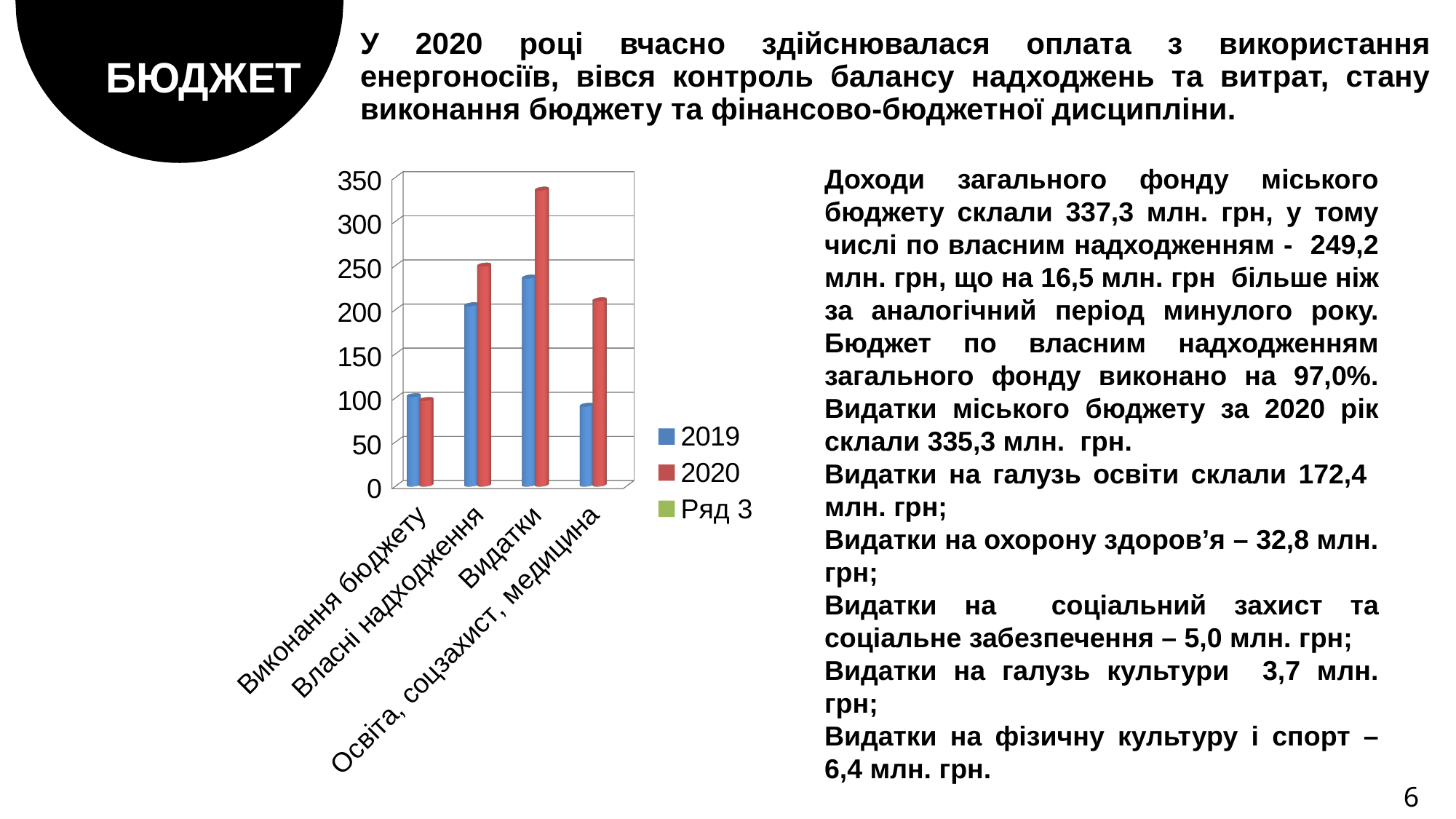
How many series does the chart legend list? 3 How many categories are shown on the x axis of the chart? 4 Which category has the highest value for the 2019 series? Видатки Is the 2019 value for Освіта, соцзахист, медицина greater or less than 150? less For Освіта, соцзахист, медицина, which series has the larger value, 2019 or 2020? 2020 What is the name of the third series listed in the legend? Ряд 3 Which series in the legend is shown in red? 2020 Which category has the highest value for the 2020 series? Видатки For Власні надходження, which series has the larger value, 2019 or 2020? 2020 Which category has the lowest value for the 2020 series? Виконання бюджету Is the 2020 value for Видатки greater or less than 300? greater What kind of chart is shown on the slide? bar chart